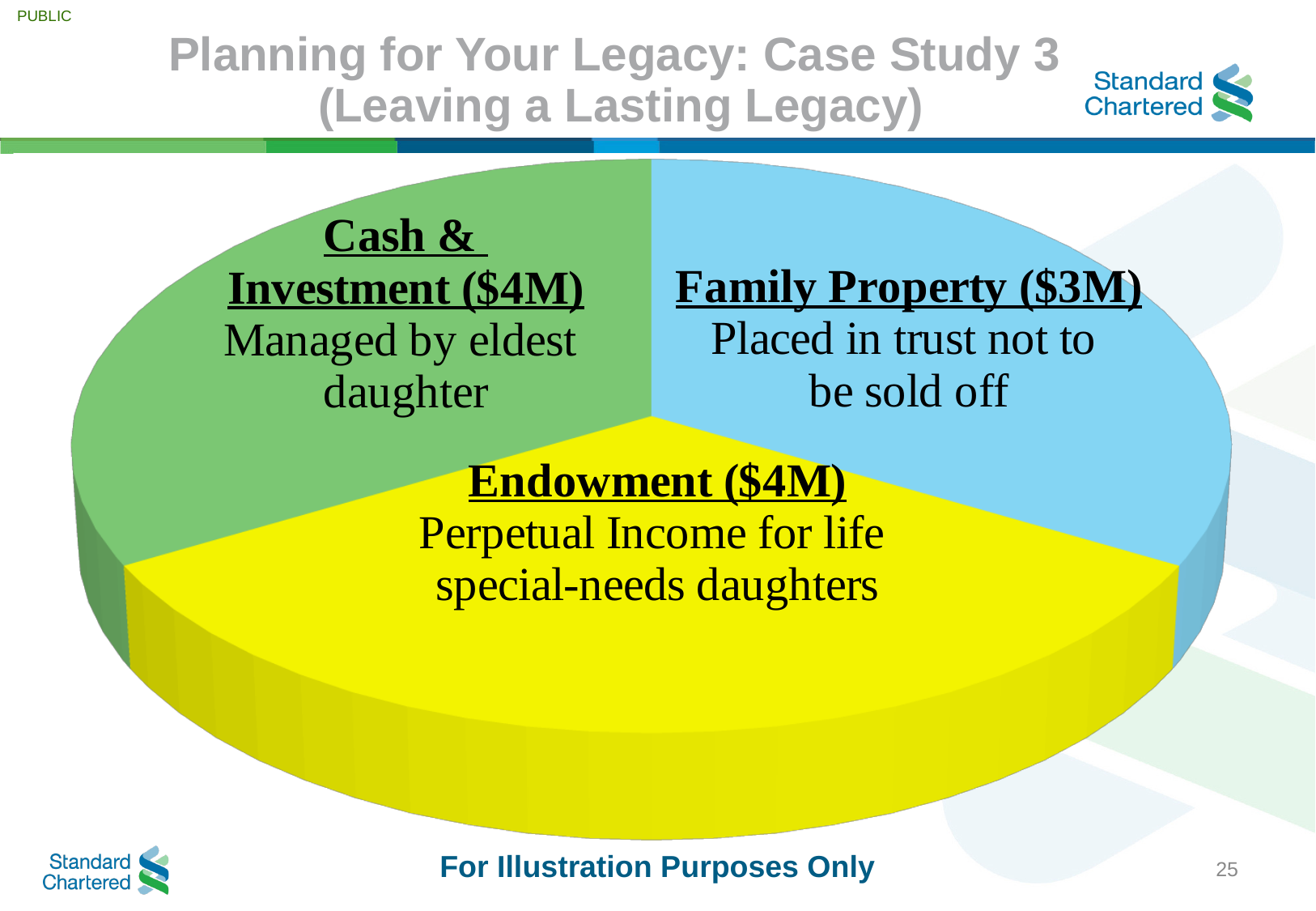
Which slice is shown in yellow? Endowment What kind of chart is shown on the slide? Pie chart What is the total value of all three slices combined? $11M Which is larger, Cash & Investment or Family Property? Cash & Investment What is the value of the Family Property slice? $3M Who manages the Cash & Investment portion according to the slice label? Eldest daughter What is the value of the Cash & Investment slice? $4M How many slices does the pie chart have? 3 Which slice has the smallest value? Family Property What is the value of the Endowment slice? $4M What is the difference between the Endowment value and the Family Property value? $1M